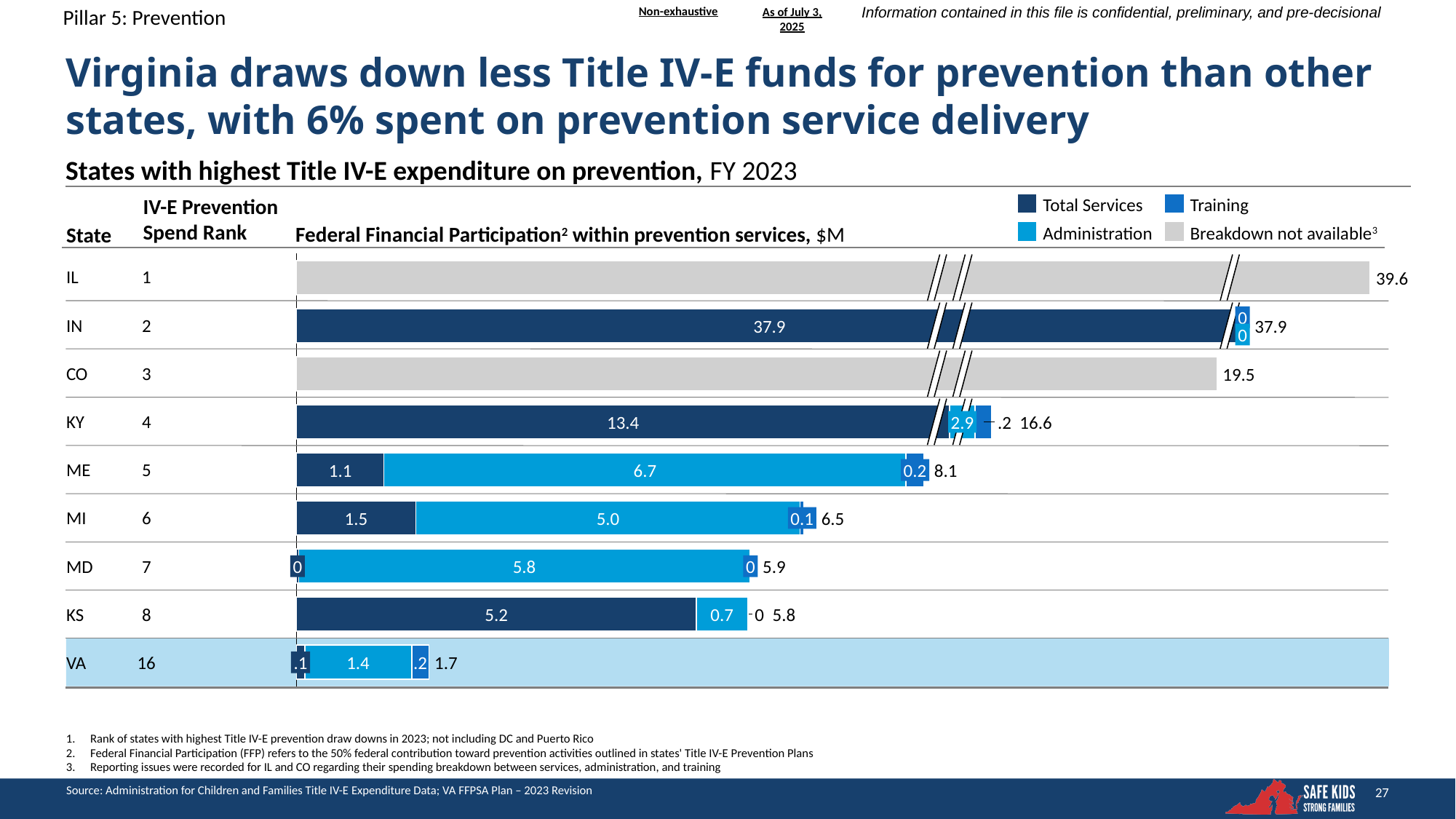
What is the Total Services value for KY? 13.4 Which state has a larger total value, ME or MI? ME Which state has the lowest total Federal Financial Participation within prevention services? VA What is the difference between the total values for IL and IN? 1.7 How many entries does the legend list? 4 What is the Administration value for ME? 6.7 What is the total Federal Financial Participation within prevention services for IL? 39.6 What is the total value shown for VA? 1.7 How many states are shown in the chart? 9 What is the IV-E Prevention Spend Rank of VA? 16 What kind of chart is shown on the slide? Stacked bar chart Which state has the highest total Federal Financial Participation within prevention services? IL